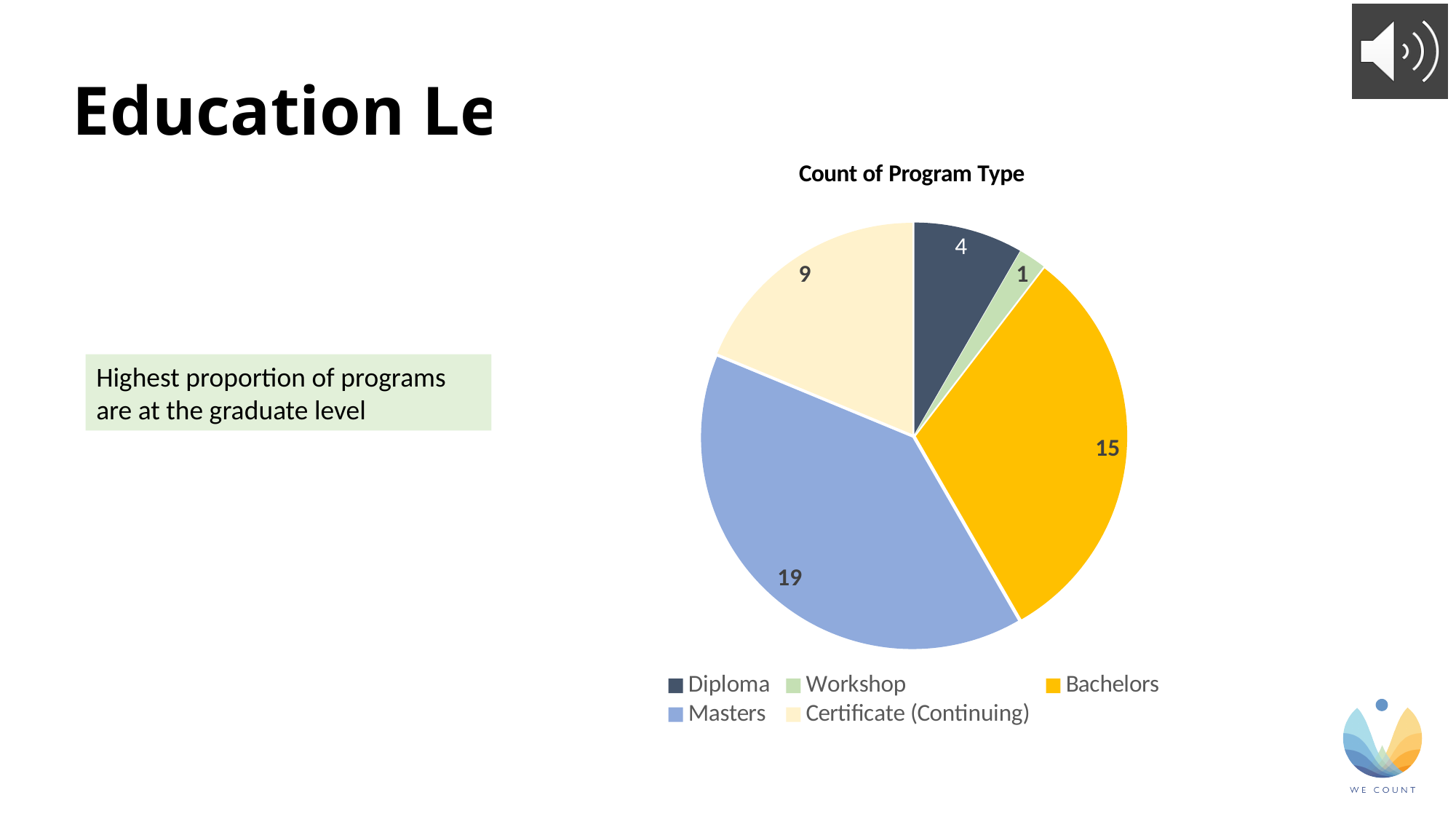
Which program type has the smallest slice in the Count of Program Type chart? Workshop What is the difference between the Masters count and the Bachelors count? 4 What is the count for Diploma in the Count of Program Type chart? 4 Which has a higher count, Certificate (Continuing) or Diploma? Certificate (Continuing) What share of the total count does the Bachelors slice represent? 31.25% What type of chart is shown on the slide? Pie chart What is the count for Masters in the Count of Program Type chart? 19 What is the count for Bachelors in the Count of Program Type chart? 15 Which program type has the largest slice in the Count of Program Type chart? Masters How many program types are shown in the pie chart? 5 What is the title of the pie chart? Count of Program Type What is the count for Certificate (Continuing) in the Count of Program Type chart? 9